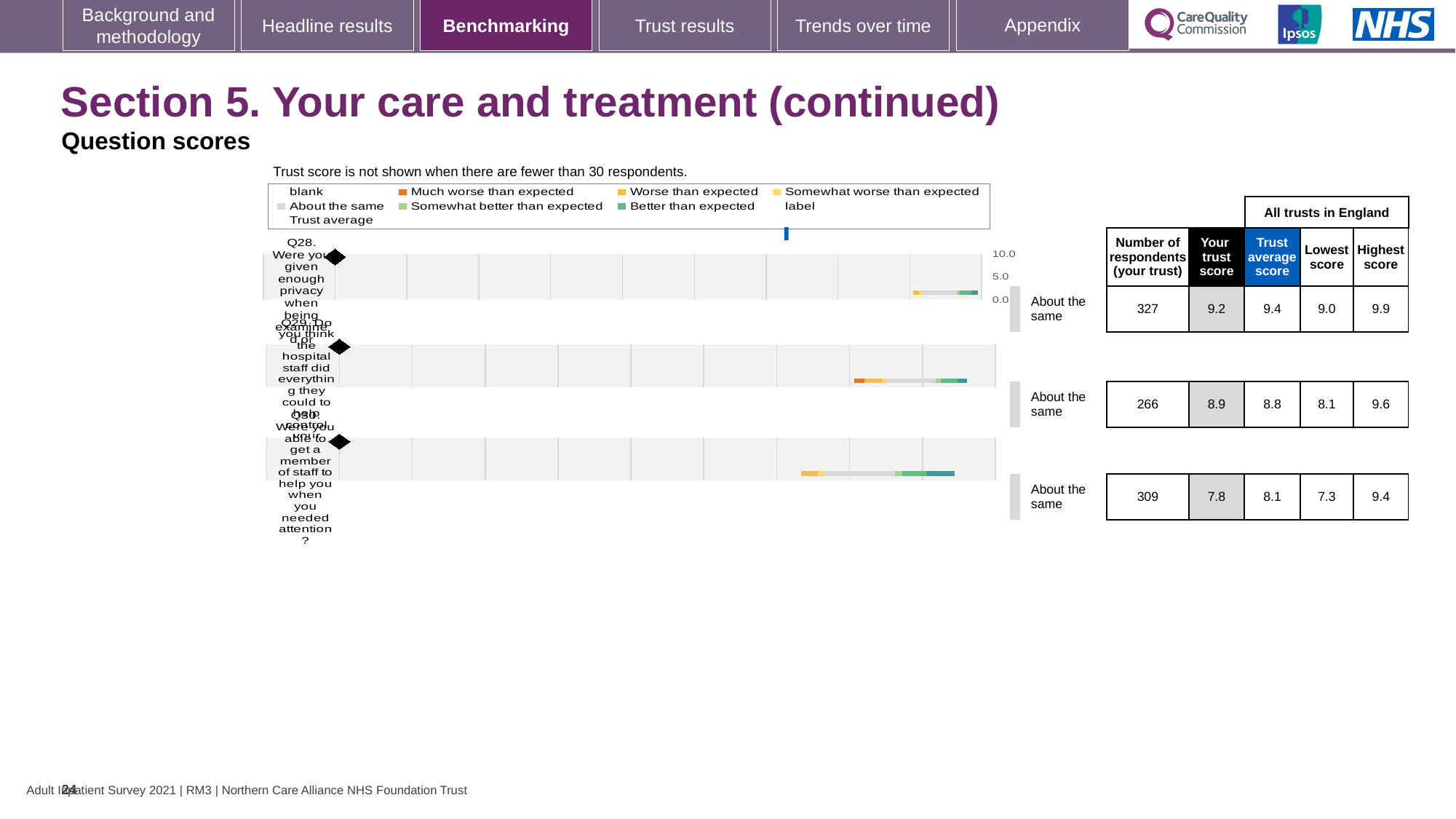
What benchmark category is shown for Q29? About the same What is the highest score across all trusts in England for Q29? 9.6 How many respondents answered Q29 for this trust? 266 Which question has the highest trust score on this slide? Q28 What is the trust score for Q30 (Were you able to get a member of staff to help you when you needed attention)? 7.8 What kind of chart is used to show the question scores? Bar chart Which question has the lowest trust score on this slide? Q30 Is the trust score for Q30 greater or less than 5.0? greater What is the difference between the trust average score and this trust's score for Q30? 0.3 How many questions are plotted on the chart? 3 What is the trust score for Q28 (Were you given enough privacy when being examined or treated)? 9.2 For Q28, which is larger: the trust's own score or the trust average score? Trust average score